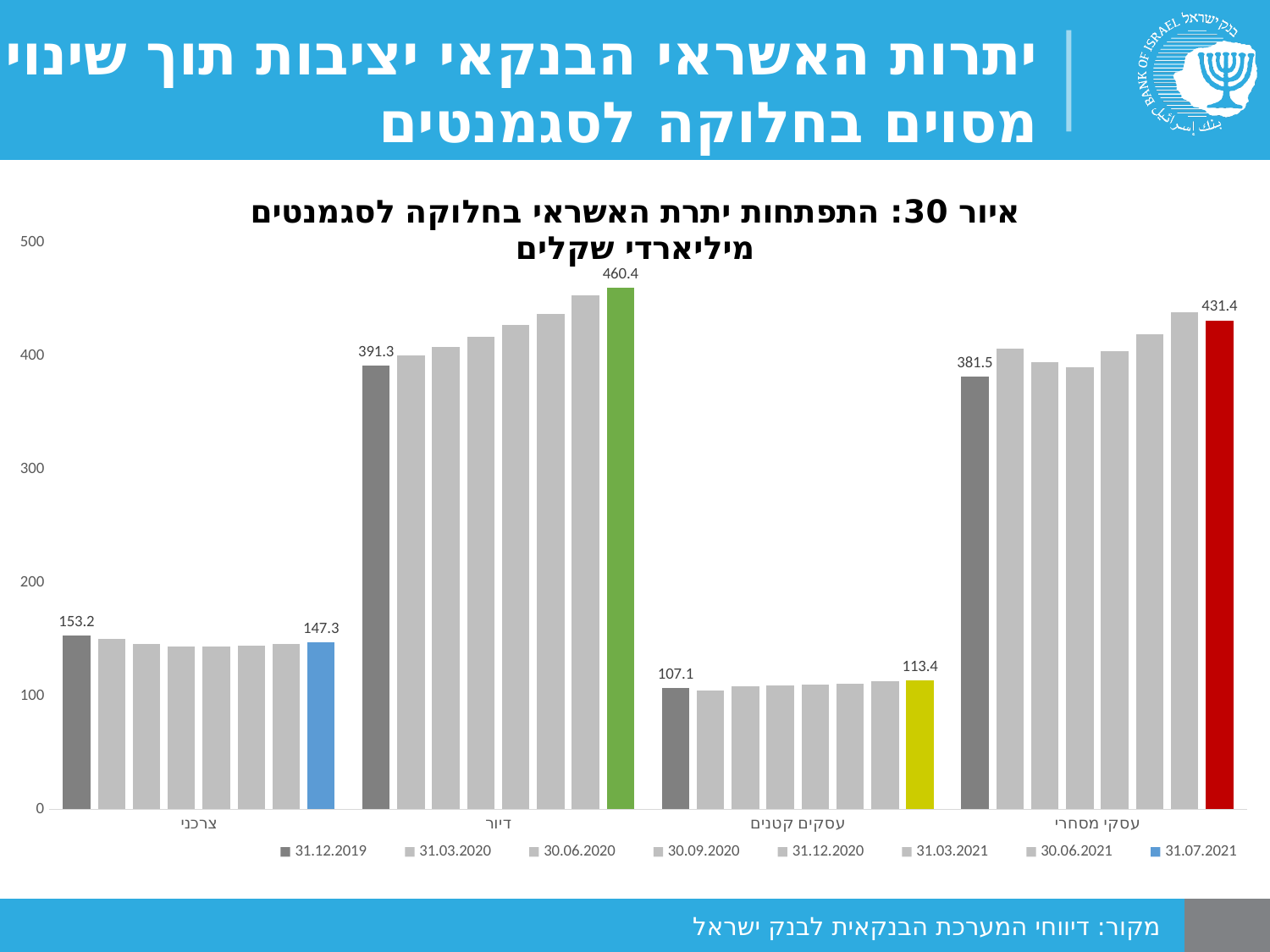
Which is larger: the צרכני value on 31.12.2019 or on 31.07.2021? 31.12.2019 Which category has the highest value on 31.07.2021? דיור How many series does the legend list? 8 What is the value for עסקים קטנים on 31.07.2021? 113.4 What is the value for צרכני on 31.12.2019? 153.2 What is the difference between the דיור values on 31.07.2021 and 31.12.2019? 69.1 Which category has the lowest value on 31.12.2019? עסקים קטנים Is the value for עסקי מסחרי on 31.03.2020 greater or less than 400? greater What is the value for דיור on 31.07.2021? 460.4 What is the value for עסקי מסחרי on 31.12.2019? 381.5 What is the difference between the עסקי מסחרי values on 31.07.2021 and 31.12.2019? 49.9 What kind of chart is shown on the slide? Bar chart